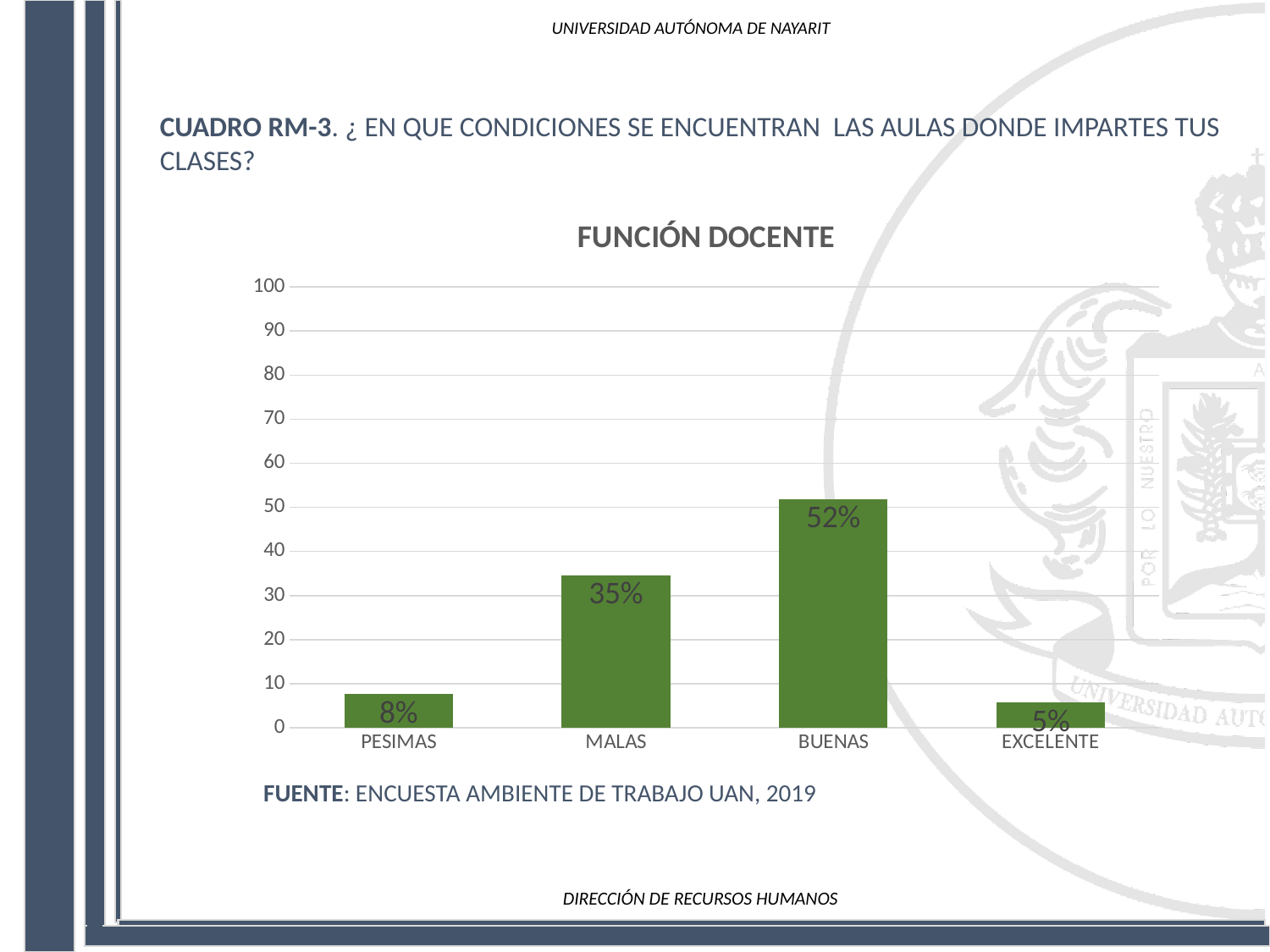
Which is larger, the value for PESIMAS or the value for EXCELENTE? PESIMAS Which category has the highest value? BUENAS What kind of chart is shown? bar chart What is the value for BUENAS? 52% What is the value for EXCELENTE? 5% How many categories are shown on the x axis? 4 Which category has the lowest value? EXCELENTE What is the value for MALAS? 35% What is the value for PESIMAS? 8% What is the title of the chart? FUNCIÓN DOCENTE What is the difference between the values for BUENAS and MALAS? 17% Is the value for MALAS greater or less than 30? greater